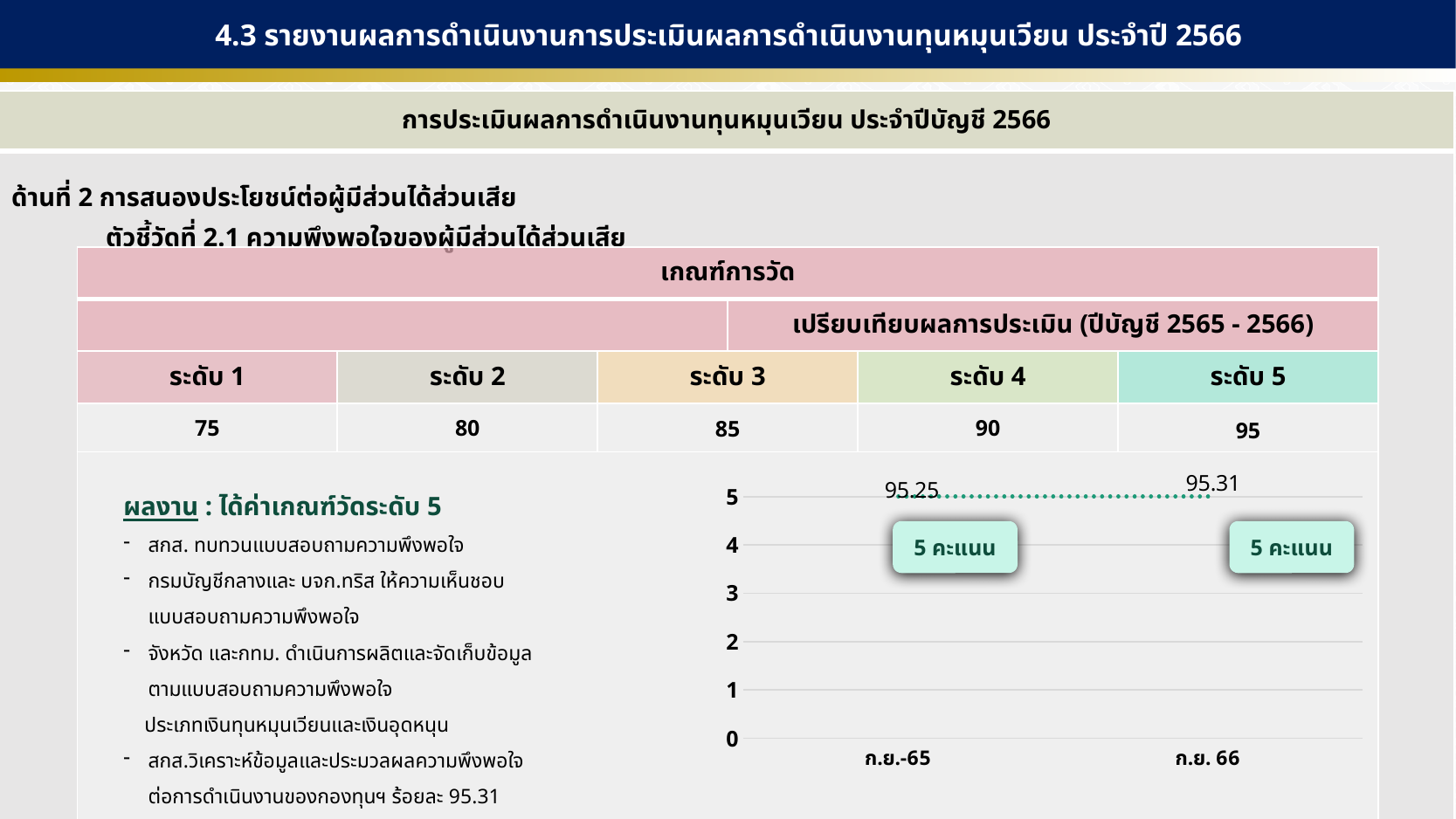
Do the labelled values rise or fall from ก.ย.-65 to ก.ย. 66? rise What value is labelled for ก.ย.-65 on the chart? 95.25 Which period has the higher labelled value, ก.ย.-65 or ก.ย. 66? ก.ย. 66 What is the highest tick value on the chart's vertical axis? 5 What value is labelled for ก.ย. 66 on the chart? 95.31 What score is shown in the callout box for ก.ย. 66? 5 คะแนน How many data points are plotted on the chart? 2 Which period has the highest labelled value on the chart? ก.ย. 66 Which period has the lowest labelled value on the chart? ก.ย.-65 What are the two category labels on the chart's horizontal axis? ก.ย.-65 and ก.ย. 66 What is the difference between the labelled values for ก.ย. 66 and ก.ย.-65? 0.06 What kind of chart is shown on the slide? line chart